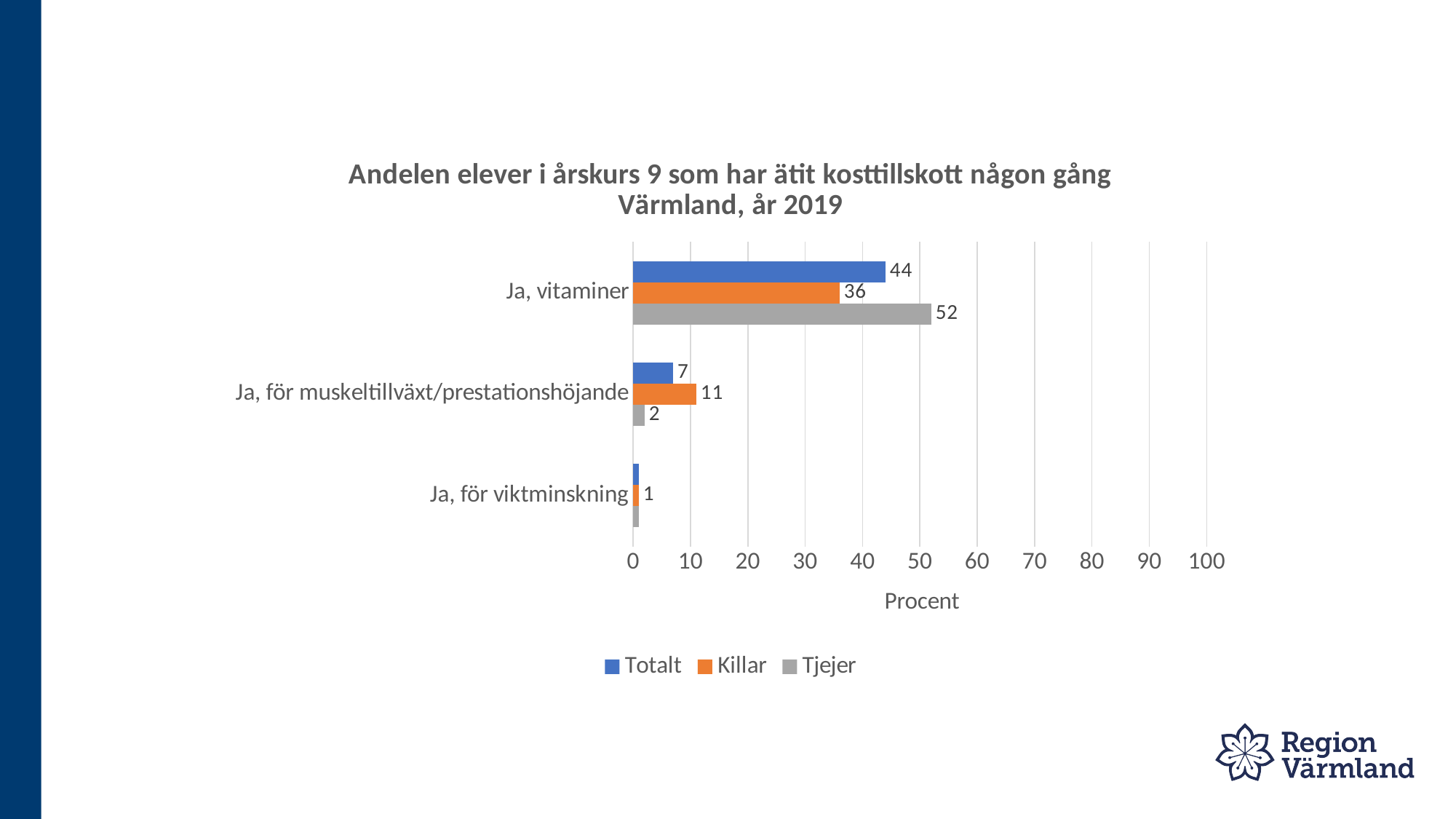
What is the value for Tjejer in the category "Ja, vitaminer"? 52 How many categories are shown on the chart? 3 Is the Totalt value for "Ja, vitaminer" greater or less than 40? greater Which series has the highest value in the category "Ja, vitaminer"? Tjejer How many series does the legend list? 3 In the category "Ja, för muskeltillväxt/prestationshöjande", which is larger: the Killar value or the Totalt value? Killar What is the difference between the Tjejer and Killar values in the category "Ja, vitaminer"? 16 What is the value for Killar in the category "Ja, vitaminer"? 36 Which series has the lowest value in the category "Ja, för muskeltillväxt/prestationshöjande"? Tjejer What is the value for Killar in the category "Ja, för viktminskning"? 1 What is the value for Totalt in the category "Ja, för muskeltillväxt/prestationshöjande"? 7 What kind of chart is shown on the slide? Bar chart